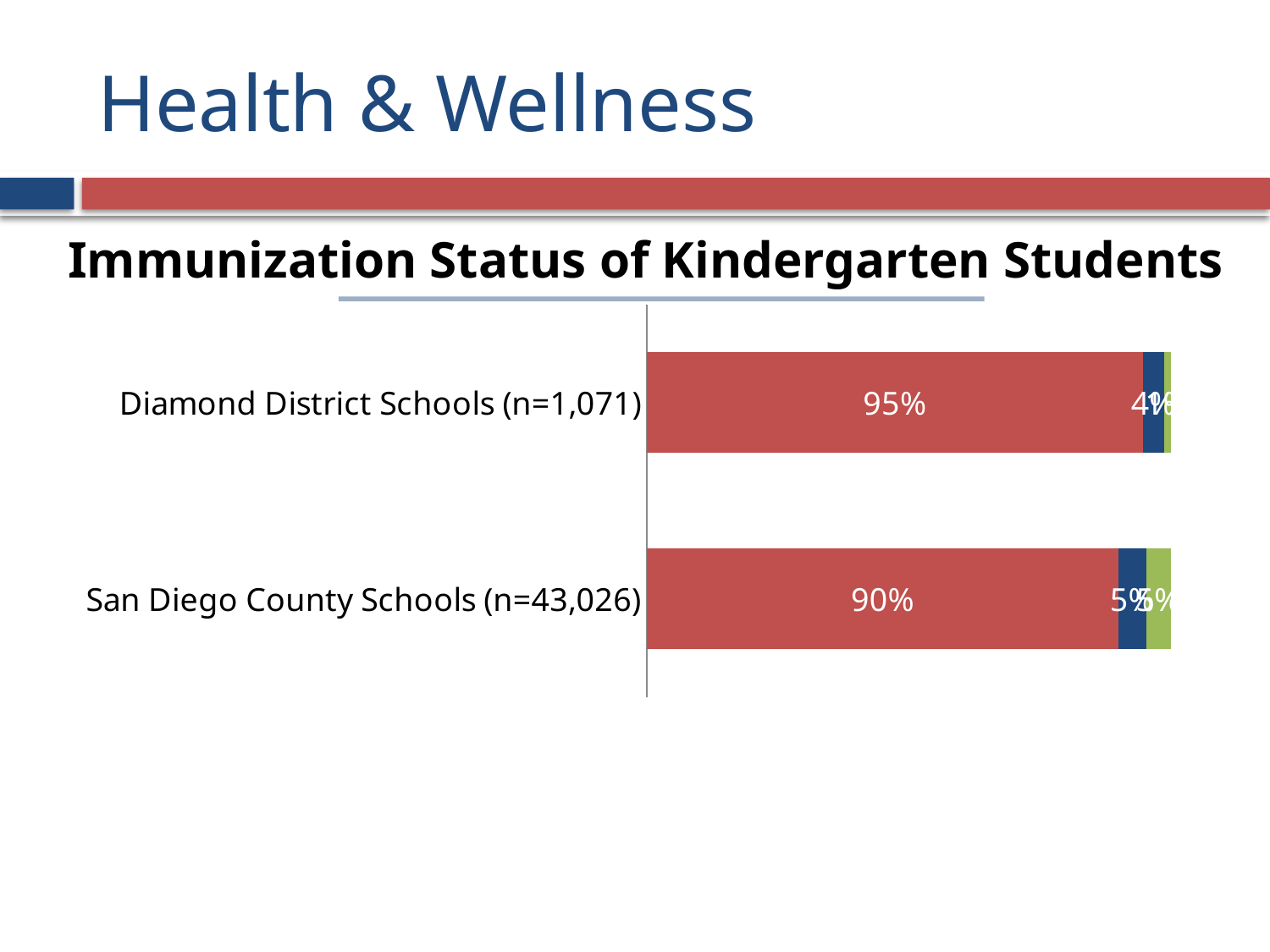
What is the title of the chart? Immunization Status of Kindergarten Students What is the sample size (n) shown for San Diego County Schools? 43,026 What kind of chart is shown on the slide? Stacked bar chart What colour is the largest segment in each bar? Red Which category has the highest value in the red (first) segment? Diamond District Schools (n=1,071) Which category has the lowest value in the red (first) segment? San Diego County Schools (n=43,026) What is the value of the red (first) segment for San Diego County Schools (n=43,026)? 90% What is the difference between the red segment values for Diamond District Schools (95%) and San Diego County Schools (90%)? 5 percentage points Which category has the larger red (first) segment, Diamond District Schools or San Diego County Schools? Diamond District Schools What is the value of the red (first) segment for Diamond District Schools (n=1,071)? 95% How many coloured segments make up each bar? 3 How many categories (bars) are shown in the chart? 2